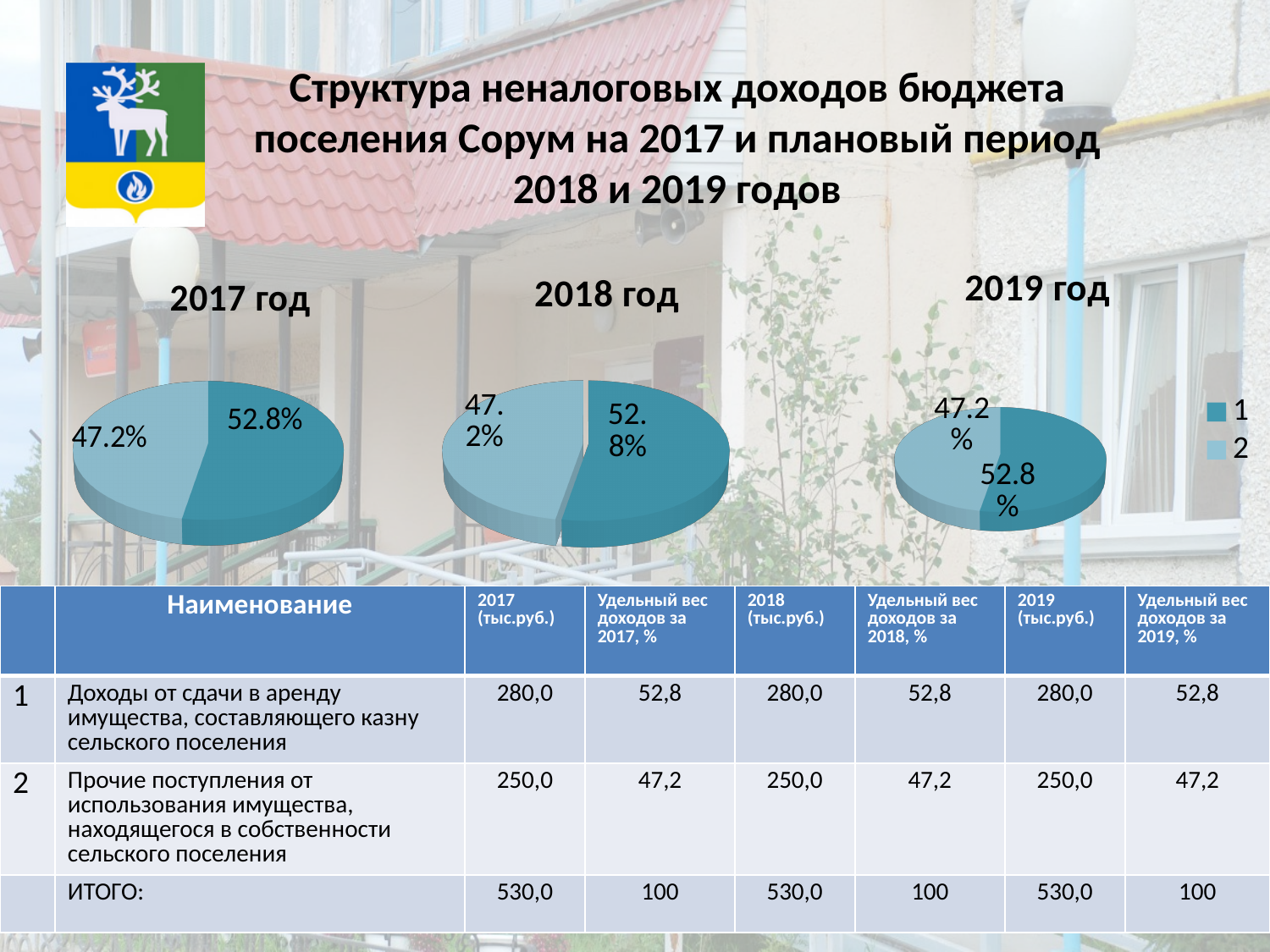
In the "2018 год" chart, which legend category has the largest slice? 1 How many slices does the "2019 год" pie chart have? 2 In the "2018 год" chart, what percentage is labelled on the lighter slice? 47.2% In the "2017 год" chart, which legend category has the smallest slice? 2 How many pie charts are shown on the slide? 3 In the "2017 год" chart, what is the difference between the two slices in percentage points? 5.6 In the "2019 год" chart, what percentage is shown for legend category 1? 52.8% How many entries does the legend next to the "2019 год" chart list? 2 In the "2018 год" chart, which slice is larger, category 1 or category 2? 1 In the "2019 год" chart, is the slice for category 2 greater or less than 50%? less What kind of chart is the "2017 год" chart? pie chart In the "2017 год" chart, what percentage is shown for the larger slice? 52.8%